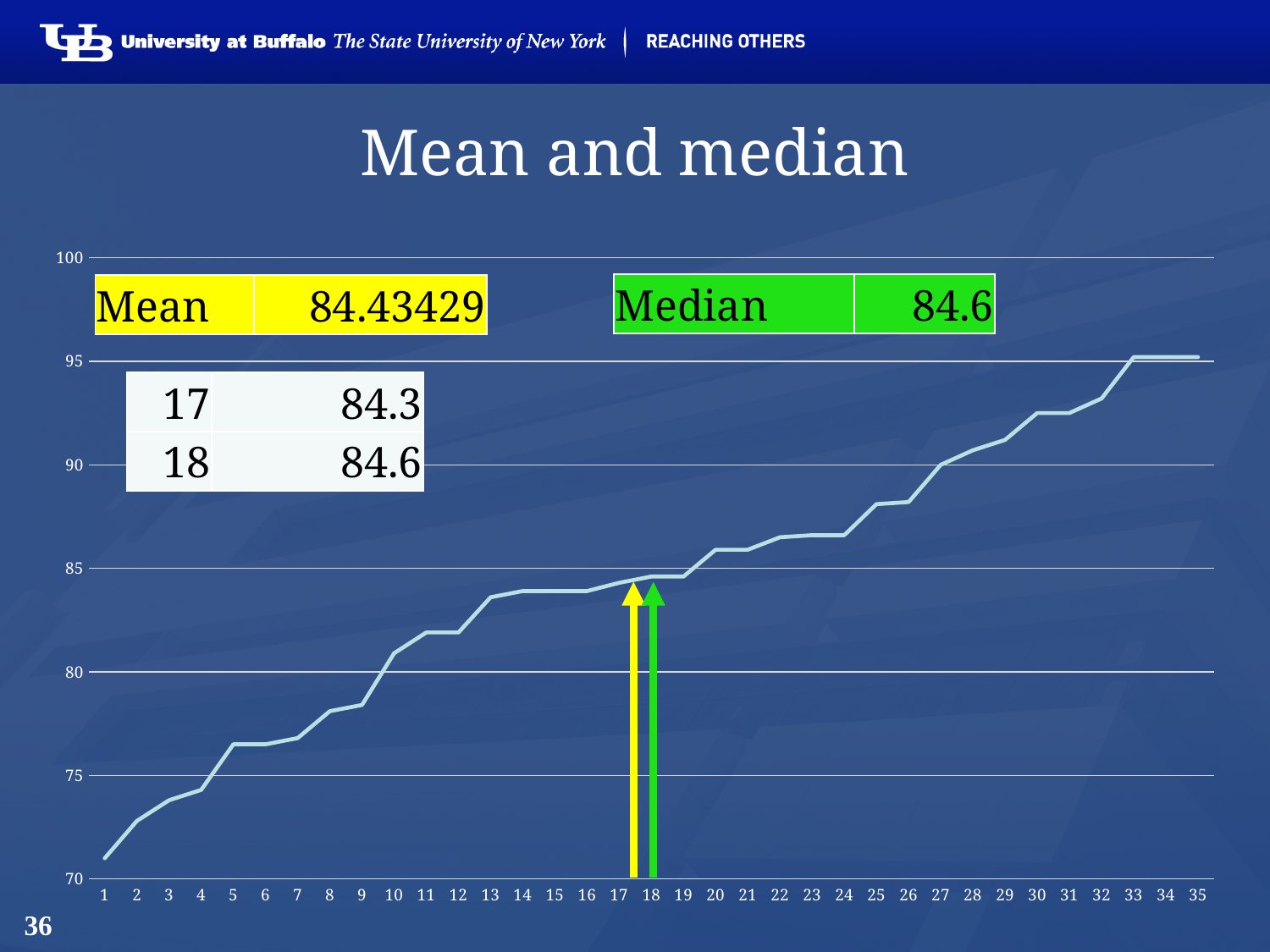
What is the value at point 17? 84.3 How many data points are plotted along the x axis? 35 Which point has the lowest value? 1 What kind of chart is shown on the slide? line chart Do the plotted values rise or fall as the x axis goes from 1 to 35? rise What mean value is shown on the slide? 84.43429 What is the value at point 18? 84.6 What is the difference between the values at points 18 and 17? 0.3 Which has the larger value, point 17 or point 18? 18 What is the title of the slide's chart? Mean and median Is the value for point 9 greater or less than 80? less Is the value for point 30 greater or less than 90? greater